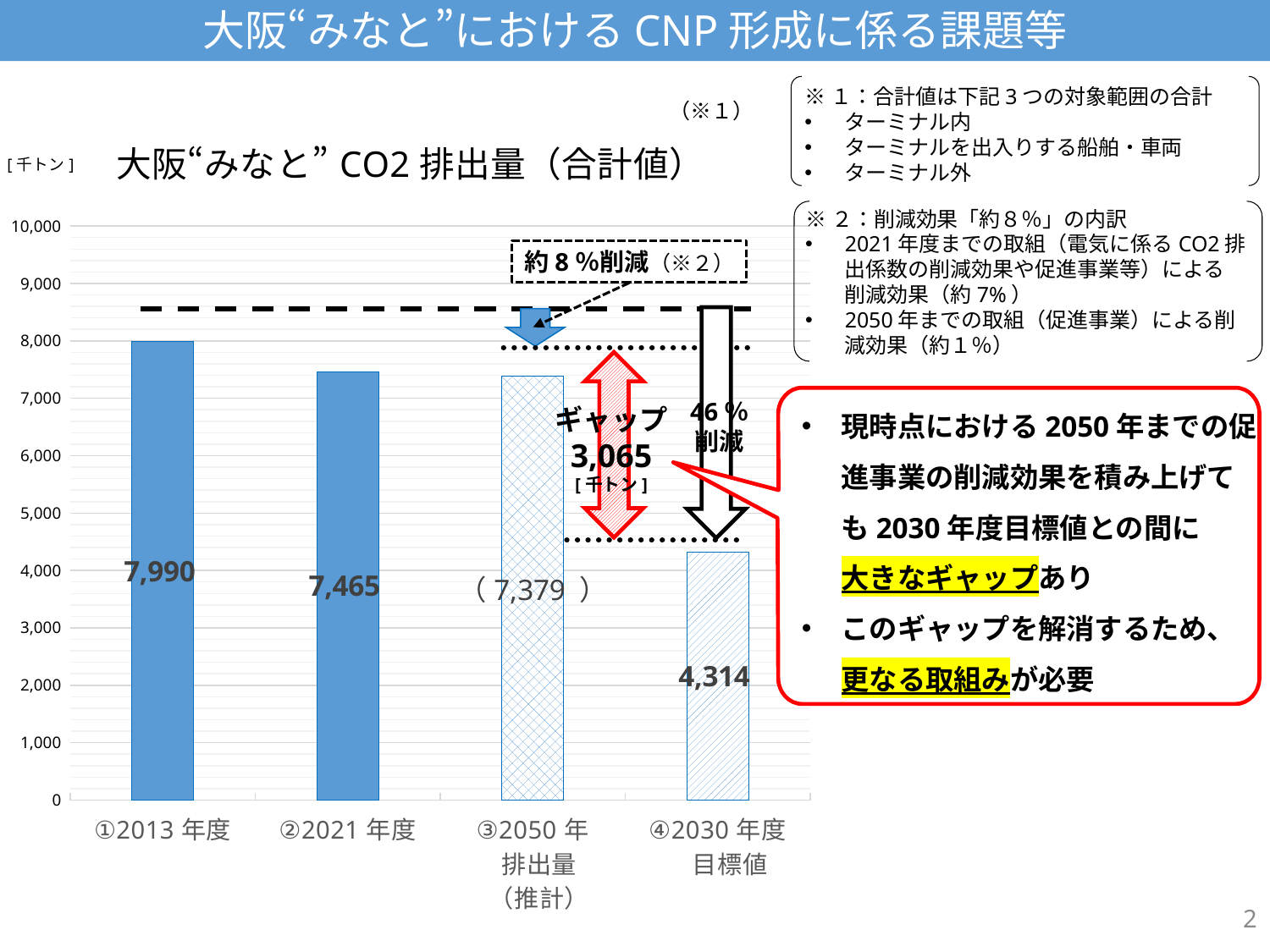
What unit is shown for the chart's vertical axis? 千トン Which is larger, the value for ②2021年度 or the value for ③2050年排出量（推計）? ②2021年度 What is the value of the ④2030年度目標値 bar? 4,314 What is the difference between the ①2013年度 value and the ②2021年度 value? 525 What type of chart is shown on the slide? Bar chart Which category has the lowest value in the chart? ④2030年度目標値 Which category has the highest value in the chart? ①2013年度 What is the difference between the ③2050年排出量（推計） value and the ④2030年度目標値 value? 3,065 How many bars (categories) are plotted in the chart? 4 What value is shown for ③2050年排出量（推計）? 7,379 What is the CO2 emission value shown for ②2021年度? 7,465 What is the CO2 emission value shown for ①2013年度? 7,990